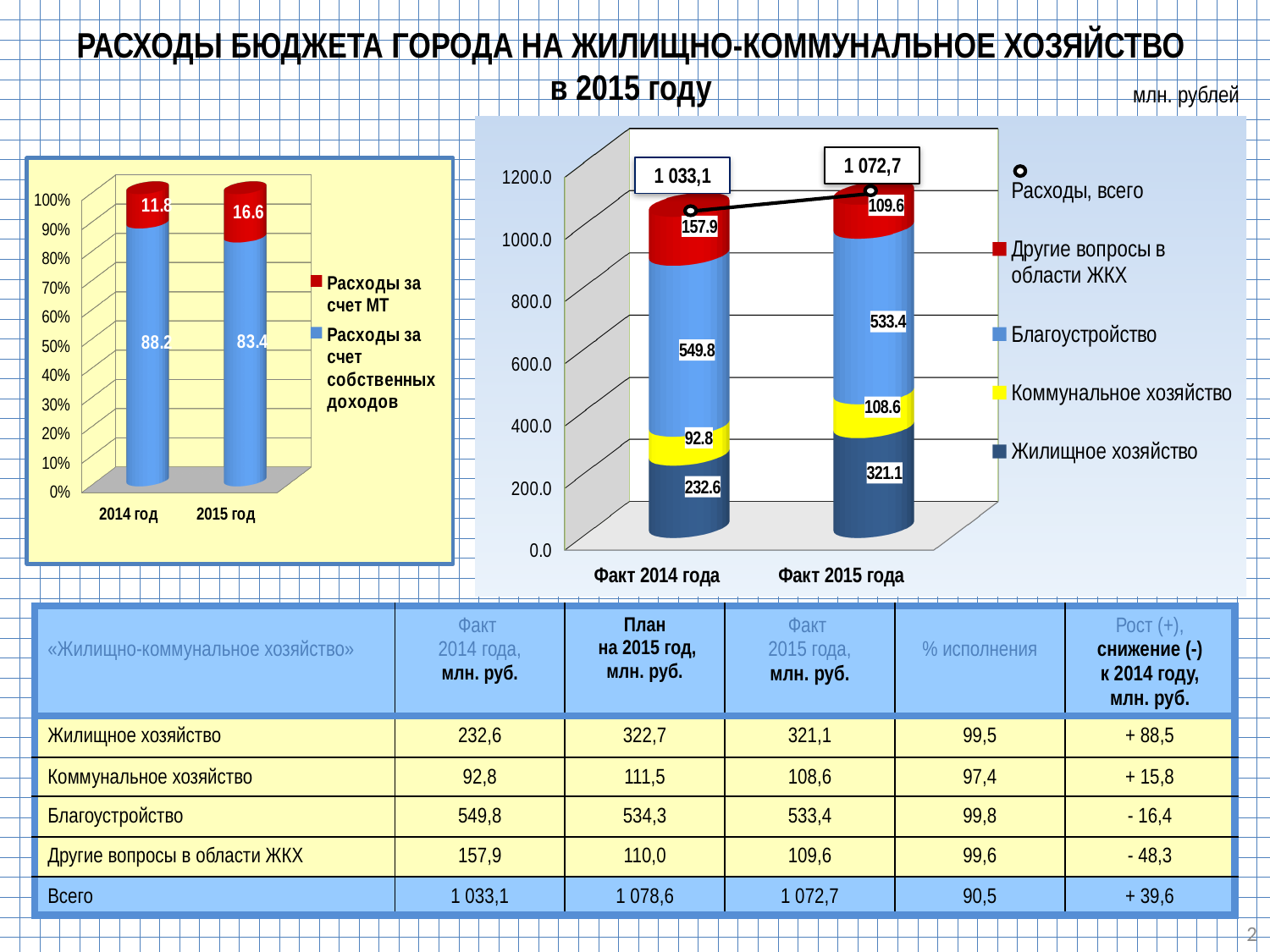
What kind of chart is the left-hand chart? stacked bar chart In the right-hand chart, what is the value of Благоустройство for Факт 2014 года? 549.8 In the left-hand chart, does the share of Расходы за счет МТ rise or fall from 2014 год to 2015 год? rise In the right-hand chart, what is the value of Жилищное хозяйство for Факт 2015 года? 321.1 In the left-hand chart, what is the value of Расходы за счет МТ for 2015 год? 16.6 In the right-hand chart, how many series does the legend list? 5 In the right-hand chart, which segment is the largest in the Факт 2015 года bar? Благоустройство In the right-hand chart, is the value of Другие вопросы в области ЖКХ larger for Факт 2014 года or Факт 2015 года? Факт 2014 года In the right-hand chart, what is the value of Коммунальное хозяйство for Факт 2015 года? 108.6 In the right-hand chart, which segment is the smallest in the Факт 2014 года bar? Коммунальное хозяйство In the left-hand chart, what is the value of Расходы за счет собственных доходов for 2014 год? 88.2 In the right-hand chart, what is the total Расходы, всего for Факт 2014 года? 1 033,1